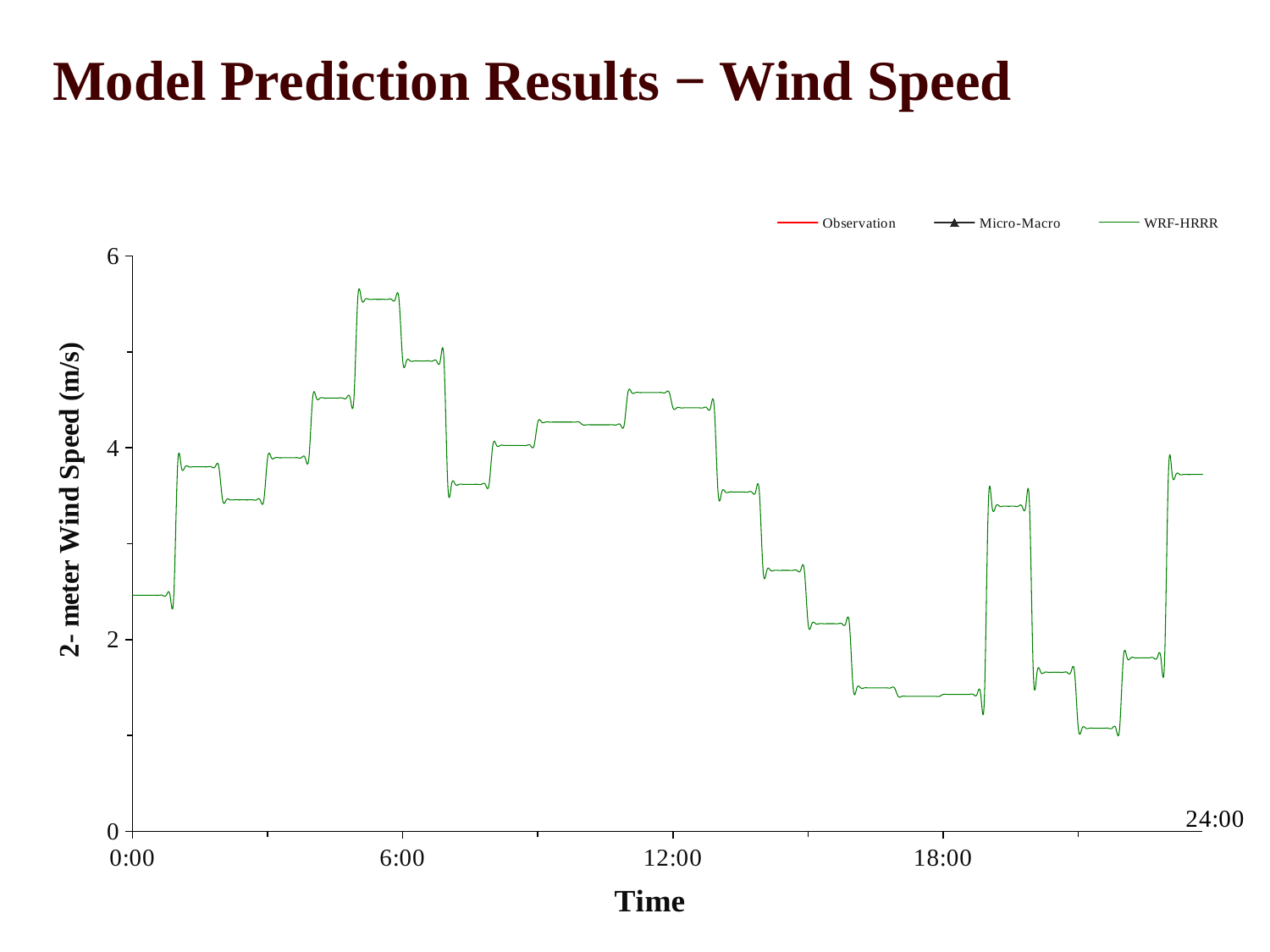
Which is larger, the wind speed at 0:00 or the wind speed at 12:00? 12:00 Which is larger, the wind speed at 6:00 or the wind speed at 18:00? 6:00 Is the wind speed at 6:00 greater or less than 4? greater What is the title of the chart? Model Prediction Results – Wind Speed Is the wind speed at 12:00 greater or less than 4? greater Is the wind speed at 24:00 greater or less than 2? greater Do the wind speed values rise or fall between 12:00 and 18:00? fall What kind of chart is shown on the slide? line chart How many series does the legend list? 3 What is the label of the y axis? 2- meter Wind Speed (m/s)